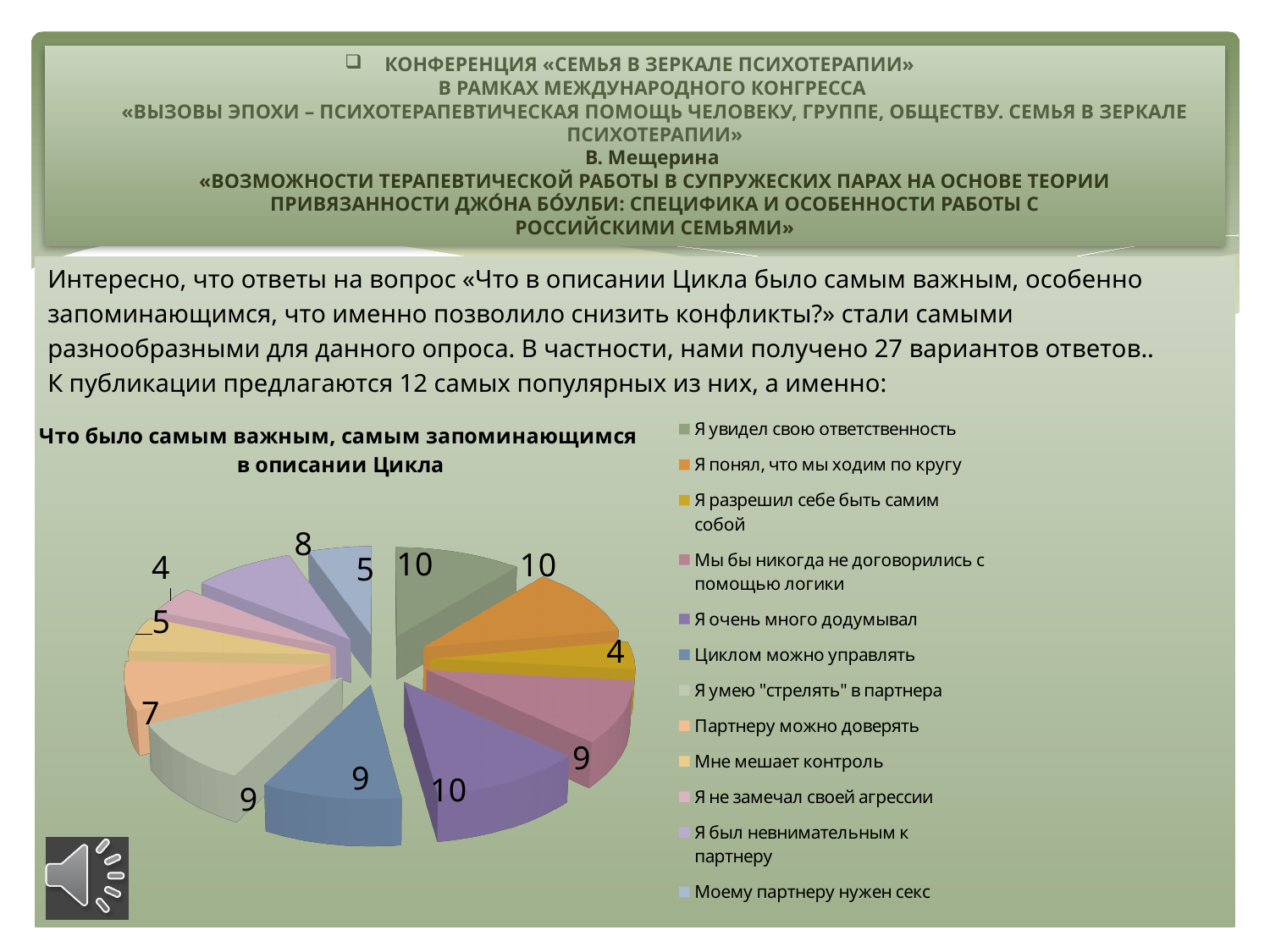
How many slices does the pie chart have? 12 Which is larger, the value for "Я очень много додумывал" or the value for "Мне мешает контроль"? Я очень много додумывал What is the value for "Моему партнеру нужен секс"? 5 What is the value for "Я увидел свою ответственность"? 10 What is the total of all the slice values in the pie chart? 90 What is the difference between the value for "Я понял, что мы ходим по кругу" and the value for "Партнеру можно доверять"? 3 What is the value for "Я был невнимательным к партнеру"? 8 What is the value for "Циклом можно управлять"? 9 What is the value for "Я разрешил себе быть самим собой"? 4 What is the value for "Партнеру можно доверять"? 7 What kind of chart is shown on the slide? pie chart What is the title of the chart? Что было самым важным, самым запоминающимся в описании Цикла